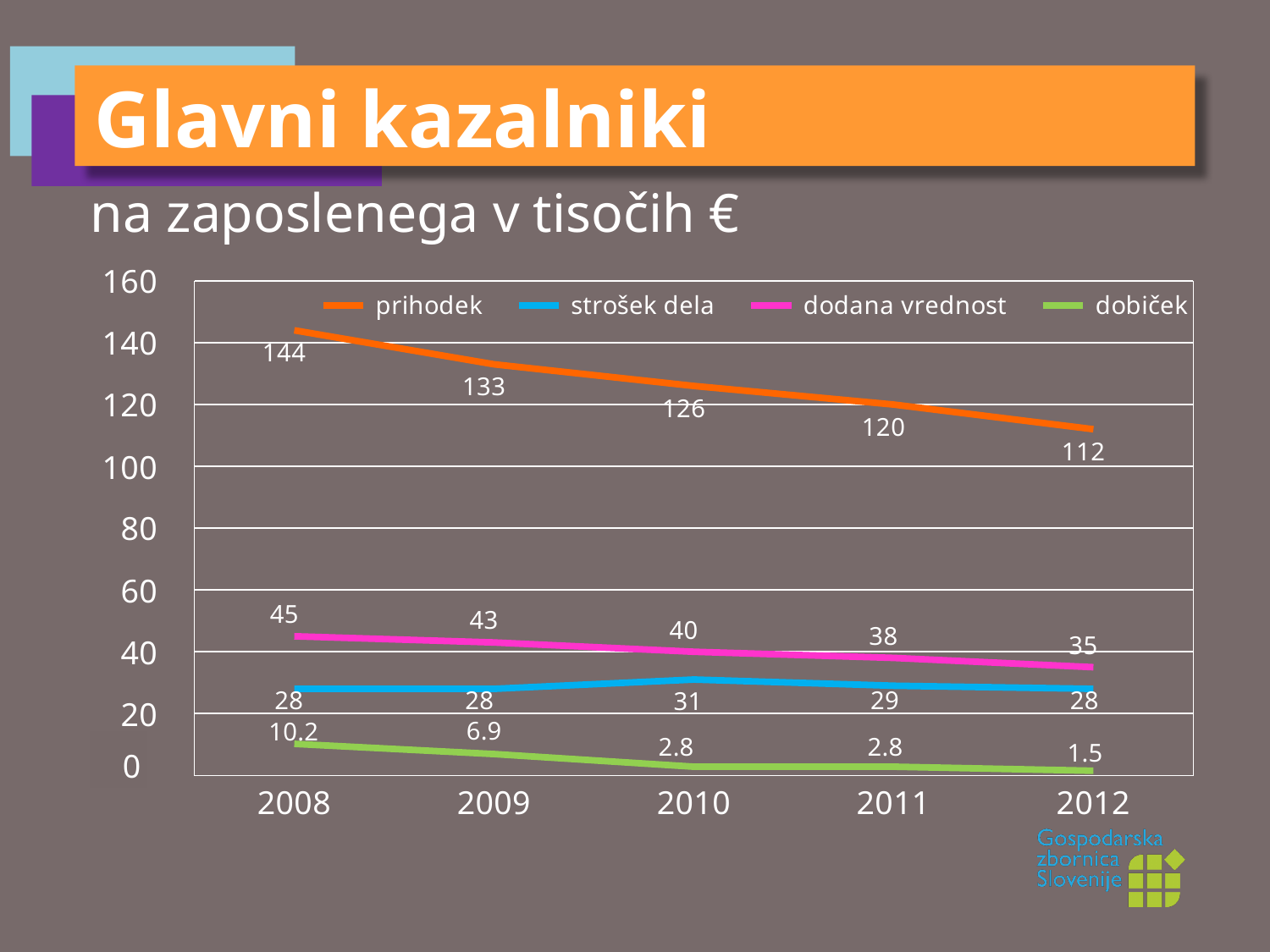
In which year is dobiček highest? 2008 How many series does the legend list? 4 In which year is prihodek lowest? 2012 How many years are shown on the x axis? 5 What is the value of dodana vrednost in 2012? 35 What is the value of prihodek in 2008? 144 Which is larger, dodana vrednost in 2010 or strošek dela in 2010? dodana vrednost in 2010 What is the value of dobiček in 2009? 6.9 Does dodana vrednost rise or fall from 2008 to 2012? fall What is the value of strošek dela in 2010? 31 What is the difference between prihodek in 2008 and prihodek in 2012? 32 What kind of chart is shown on the slide? line chart